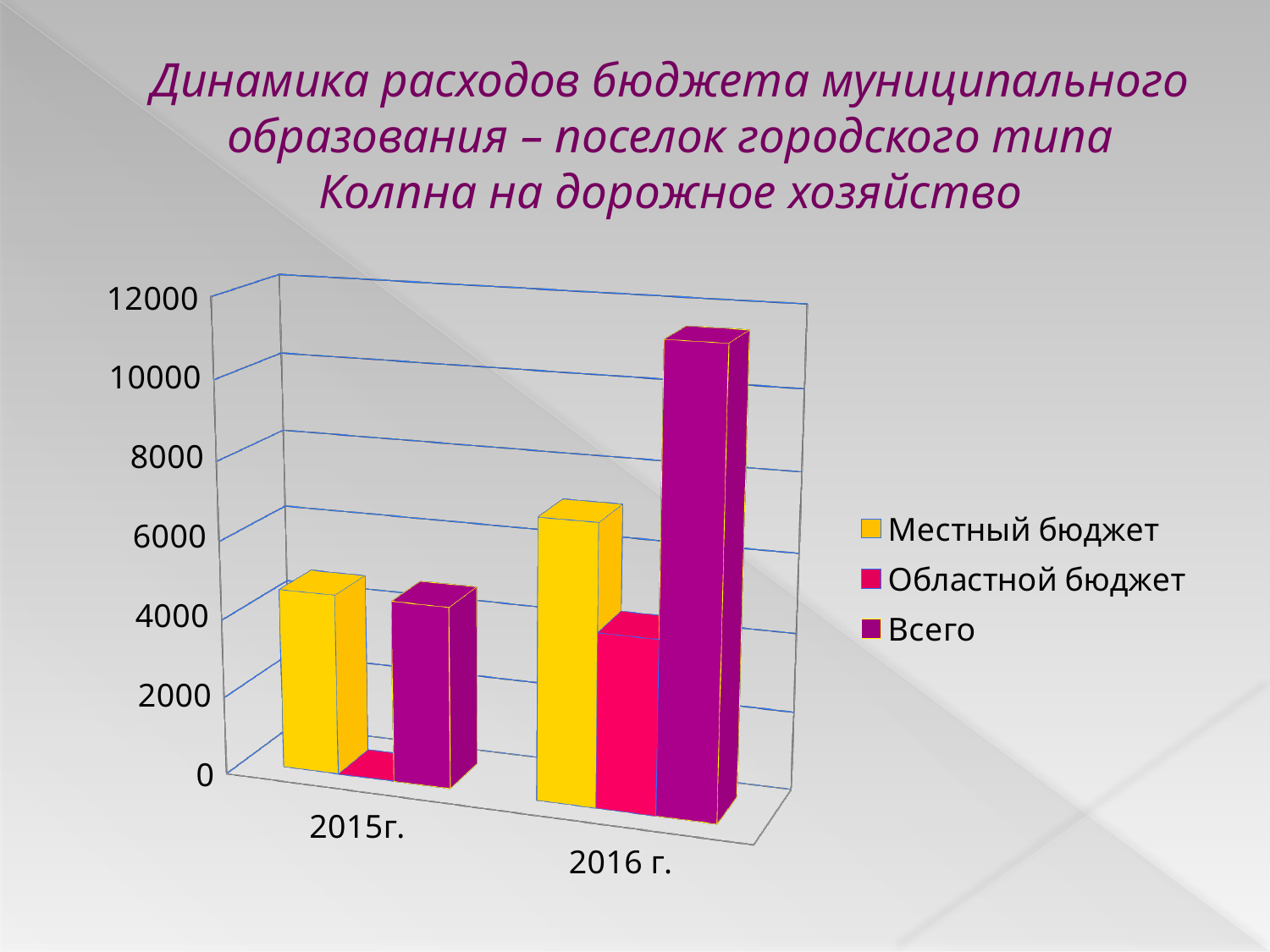
Is the value of Всего for 2016 г. greater or less than 10000? greater Which bar is the tallest in the chart? Всего for 2016 г. Is the value of Областной бюджет for 2015г. greater or less than 2000? less How many series does the legend list? 3 What kind of chart is shown on the slide? bar chart Is the value of Местный бюджет for 2016 г. greater or less than 4000? greater Which bar is the shortest in the chart? Областной бюджет for 2015г. Do the values of Всего rise or fall from 2015г. to 2016 г.? rise What colour represents the Всего series in the legend? purple Which is larger for 2016 г.: Местный бюджет or Областной бюджет? Местный бюджет How many categories (years) are shown on the x axis? 2